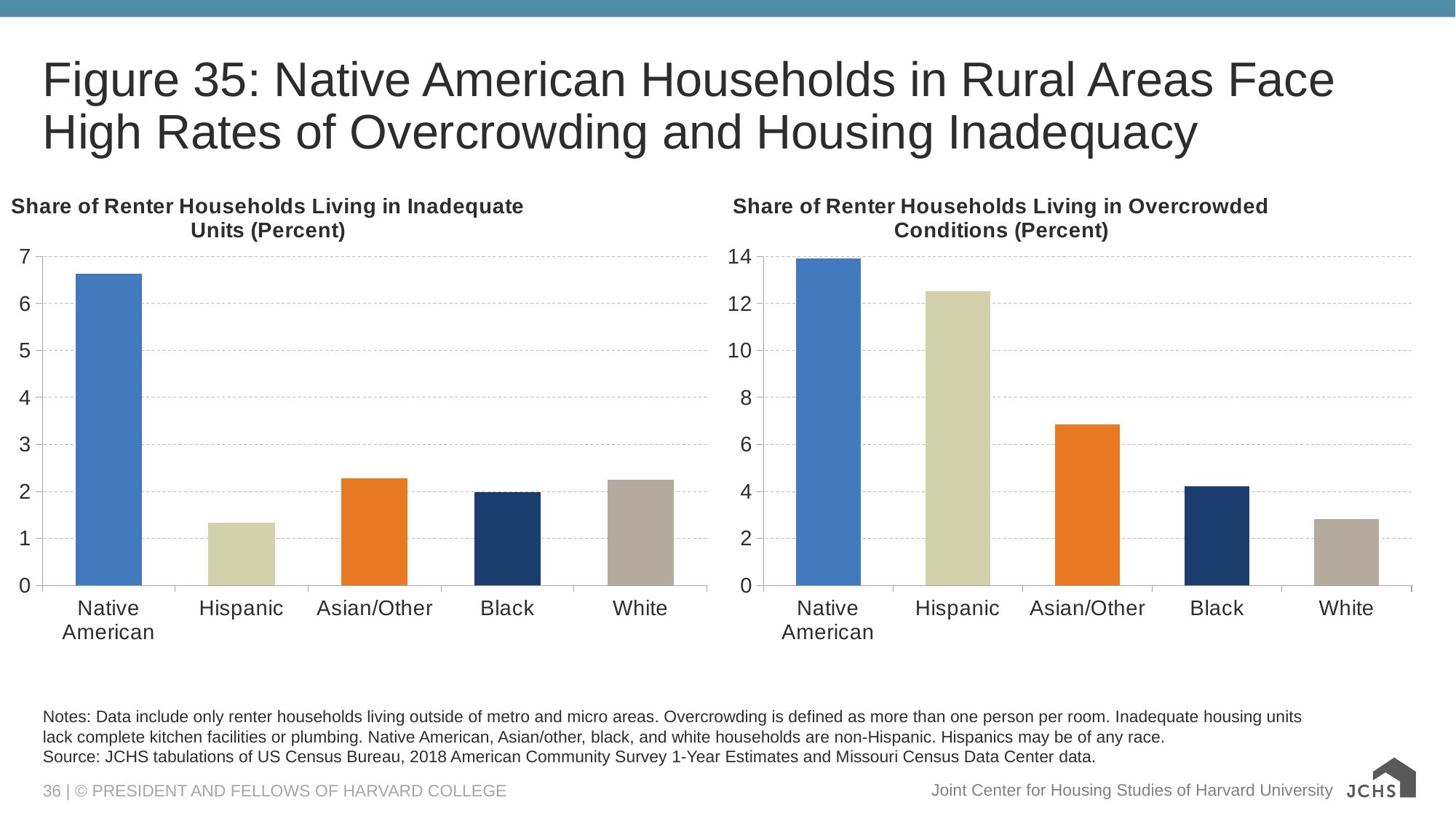
In the chart titled 'Share of Renter Households Living in Inadequate Units (Percent)', which category has the highest value? Native American What kind of chart is the left chart (Inadequate Units)? bar chart In the right chart (Overcrowded Conditions), which is larger, the value for Hispanic or the value for Asian/Other? Hispanic In the left chart (Inadequate Units), is the value for Native American greater or less than 6? greater In the right chart (Overcrowded Conditions), is the value for Asian/Other greater or less than 8? less In the chart titled 'Share of Renter Households Living in Overcrowded Conditions (Percent)', which category has the lowest value? White In the chart titled 'Share of Renter Households Living in Overcrowded Conditions (Percent)', which category has the highest value? Native American How many categories are shown in the right chart (Overcrowded Conditions)? 5 In the left chart (Inadequate Units), which is larger, the value for Native American or the value for Hispanic? Native American In the left chart (Inadequate Units), is the value for Hispanic greater or less than 2? less In the chart titled 'Share of Renter Households Living in Inadequate Units (Percent)', which category has the lowest value? Hispanic